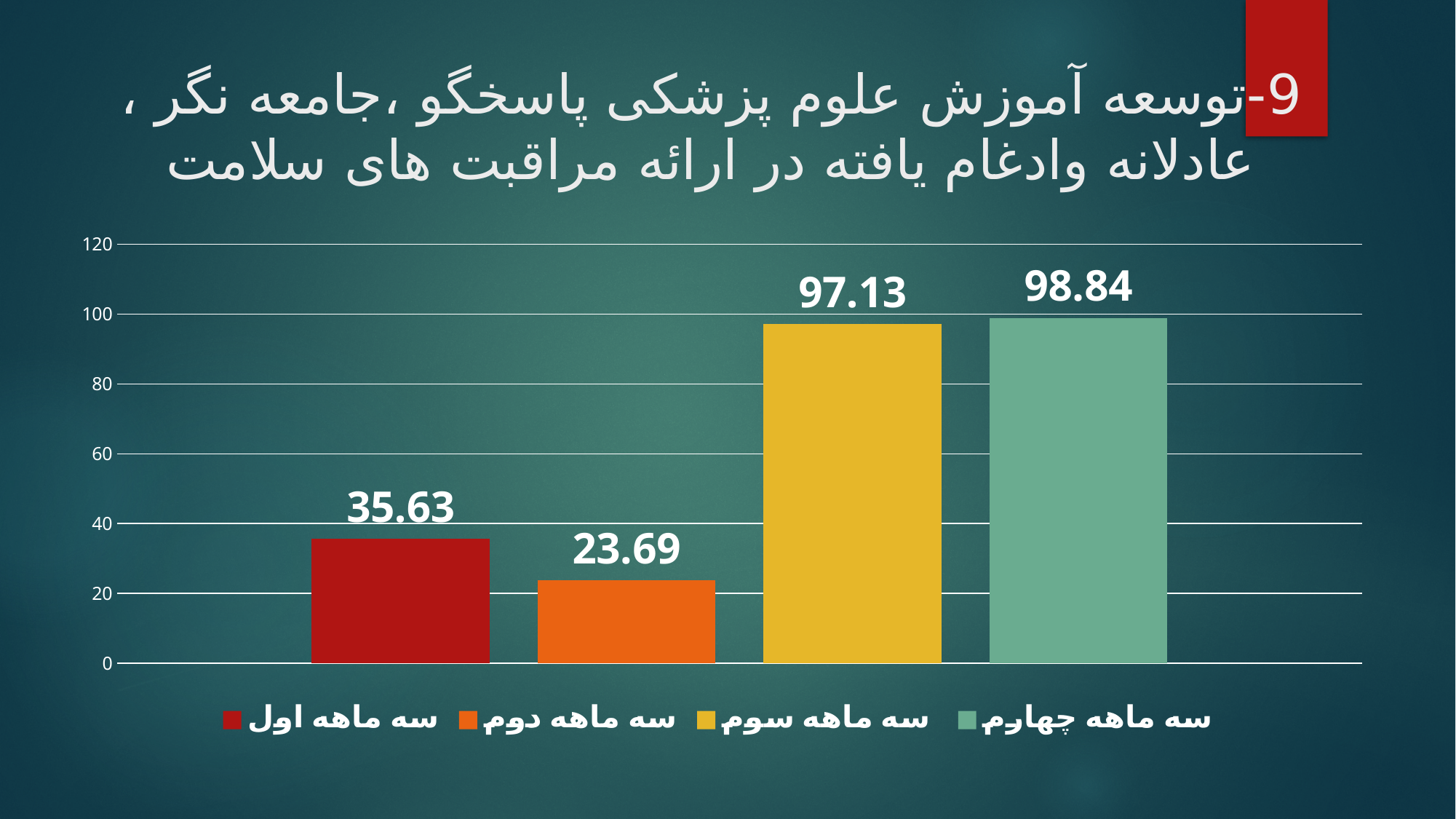
What is the difference between the values for سه ماهه اول and سه ماهه دوم? 11.94 Which is larger, the value for سه ماهه اول or the value for سه ماهه دوم? سه ماهه اول What kind of chart is shown on the slide? bar chart Is the value for سه ماهه سوم greater or less than 80? greater What is the difference between the values for سه ماهه چهارم and سه ماهه سوم? 1.71 What is the value for سه ماهه اول? 35.63 How many bars are shown in the chart? 4 What is the value for سه ماهه چهارم? 98.84 Which category has the lowest value? سه ماهه دوم What is the value for سه ماهه دوم? 23.69 Which category has the highest value? سه ماهه چهارم What is the value for سه ماهه سوم? 97.13